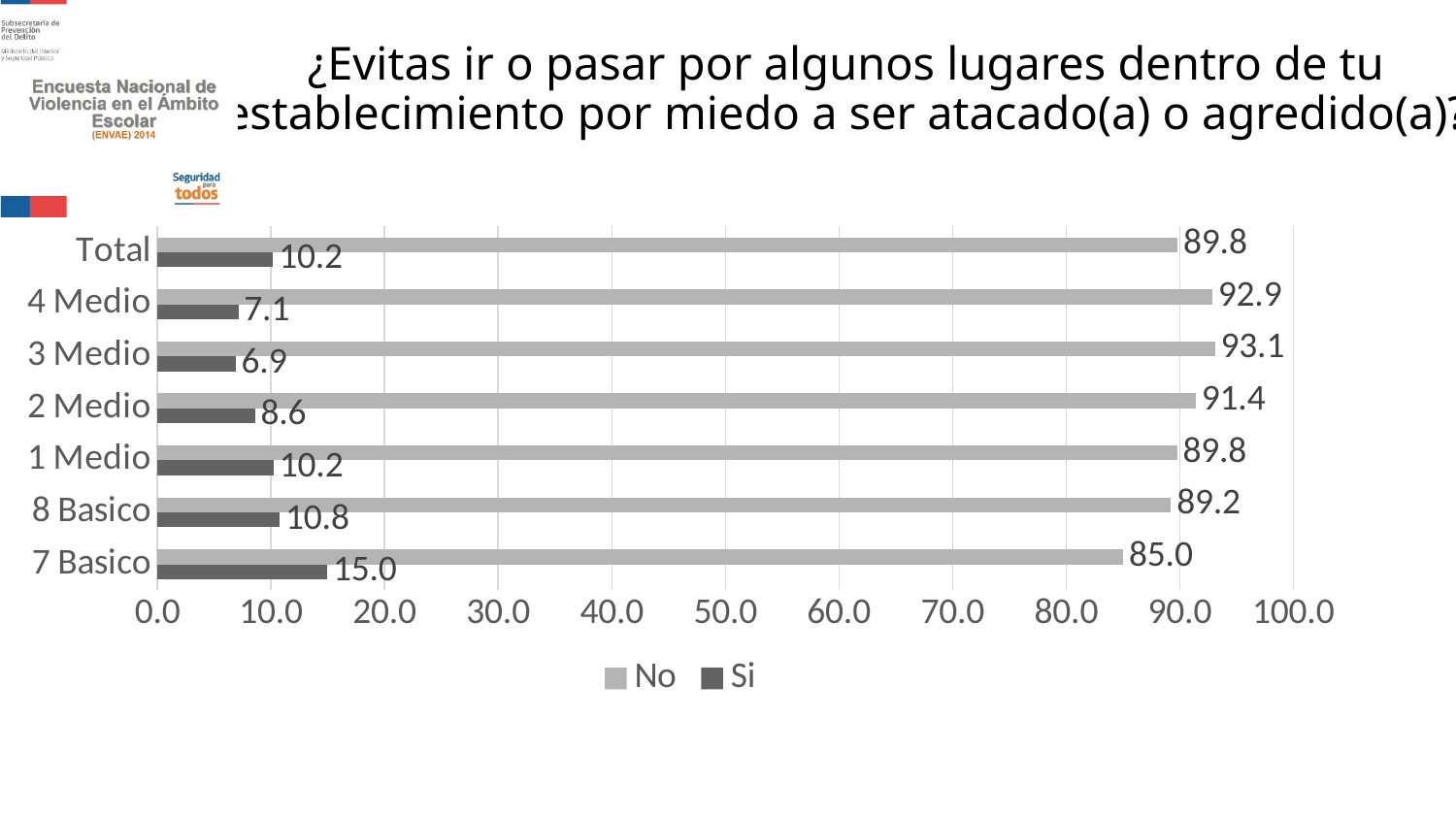
What are the two series named in the legend? No and Si Which category has the lowest "Si" value? 3 Medio Which category has the highest "Si" value? 7 Basico How many categories are shown on the y axis? 7 How many series does the legend list? 2 What is the value of the "Si" series for Total? 10.2 What kind of chart is shown on the slide? Bar chart What is the value of the "No" series for 3 Medio? 93.1 Which is larger, the "No" value for 2 Medio or for 1 Medio? 2 Medio Which category has the lowest "No" value? 7 Basico What is the difference between the "Si" values for 7 Basico and 8 Basico? 4.2 What is the value of the "Si" series for 7 Basico? 15.0